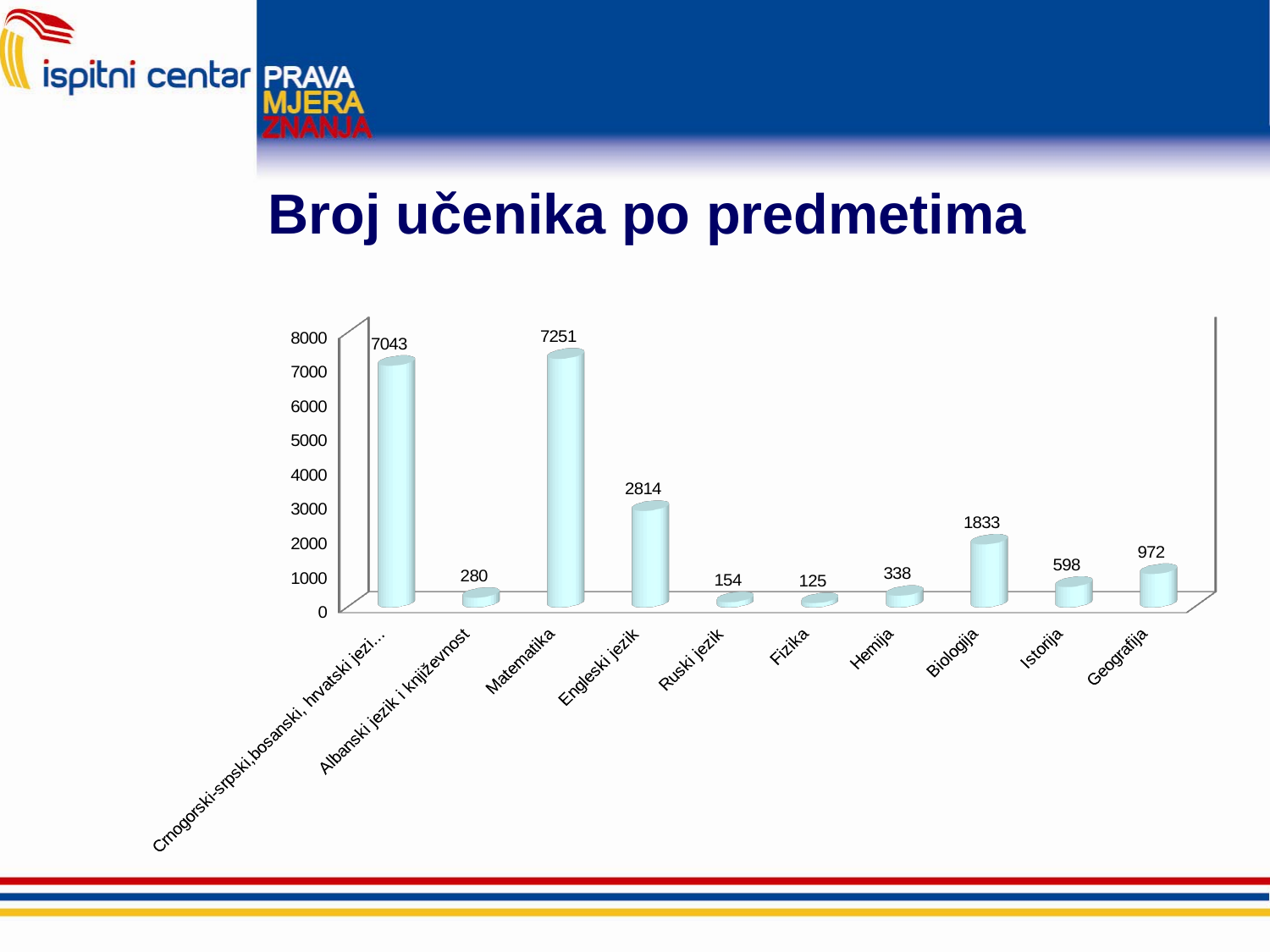
Which subject has the lowest number of students? Fizika What is the difference between the values for Geografija and Istorija? 374 What is the value for Engleski jezik? 2814 What is the value for Matematika? 7251 What is the title of the chart? Broj učenika po predmetima How many subjects are shown on the chart? 10 Is the value for Engleski jezik greater or less than 3000? less Which subject has the highest number of students? Matematika What is the value for Fizika? 125 What kind of chart is shown on the slide? bar chart Which is larger, the value for Hemija or the value for Albanski jezik i književnost? Hemija What is the value for Biologija? 1833